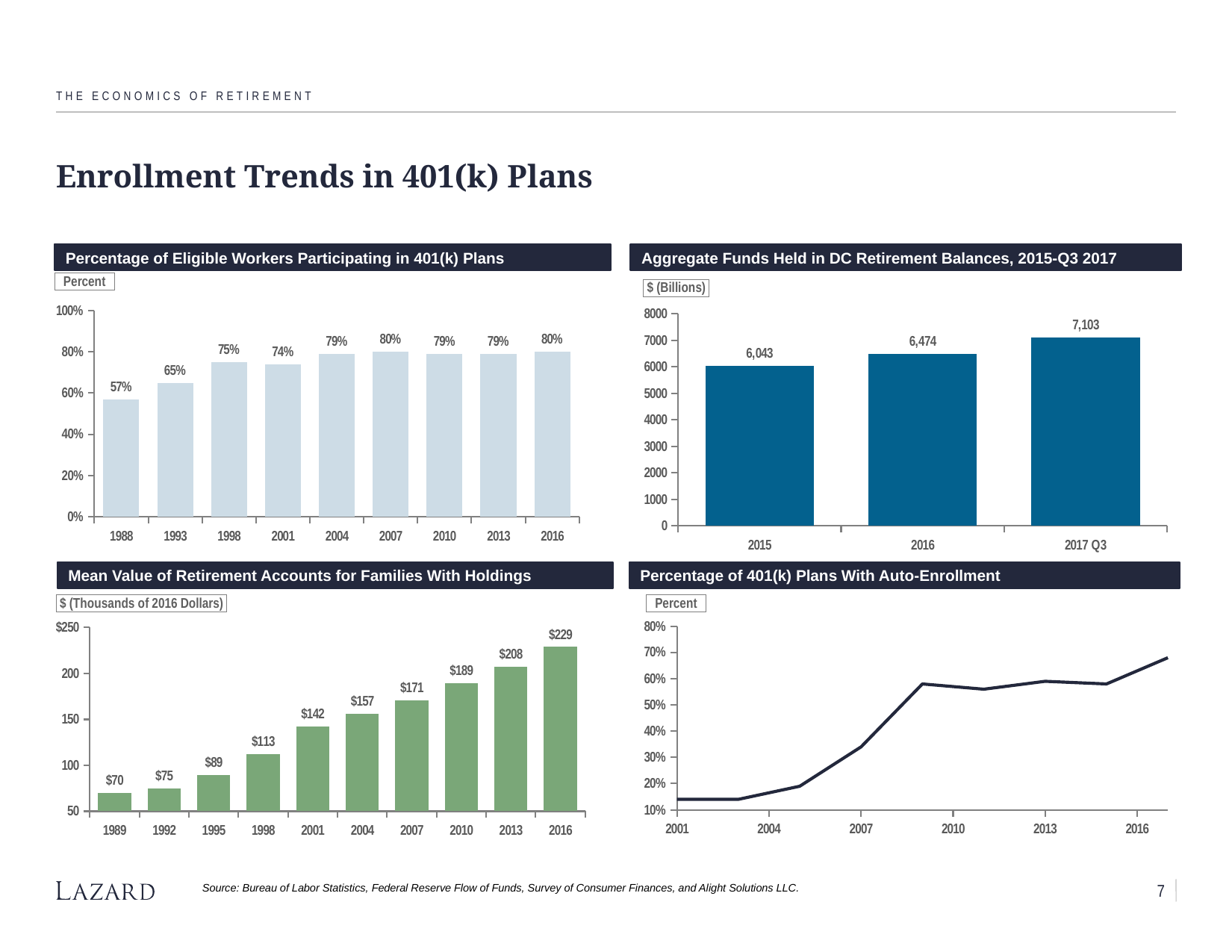
In the 'Percentage of Eligible Workers Participating in 401(k) Plans' chart, how many years are shown on the x axis? 9 In the 'Percentage of 401(k) Plans With Auto-Enrollment' chart, is the value for 2004 greater or less than 30%? less In the 'Aggregate Funds Held in DC Retirement Balances, 2015-Q3 2017' chart, what is the value for 2016? 6,474 In the 'Mean Value of Retirement Accounts for Families With Holdings' chart, do the values rise or fall from 1989 to 2016? rise In the 'Mean Value of Retirement Accounts for Families With Holdings' chart, what is the value for 2001? $142 In the 'Percentage of Eligible Workers Participating in 401(k) Plans' chart, what is the value for 1988? 57% In the 'Percentage of Eligible Workers Participating in 401(k) Plans' chart, which year has the lowest value? 1988 In the 'Percentage of 401(k) Plans With Auto-Enrollment' chart, is the value for 2016 greater or less than 50%? greater What kind of chart is 'Percentage of 401(k) Plans With Auto-Enrollment'? line chart In the 'Aggregate Funds Held in DC Retirement Balances, 2015-Q3 2017' chart, which period has the highest value? 2017 Q3 In the 'Mean Value of Retirement Accounts for Families With Holdings' chart, what is the difference between the 2016 value and the 1989 value? $159 In the 'Aggregate Funds Held in DC Retirement Balances, 2015-Q3 2017' chart, what is the difference between the 2017 Q3 value and the 2015 value? 1,060